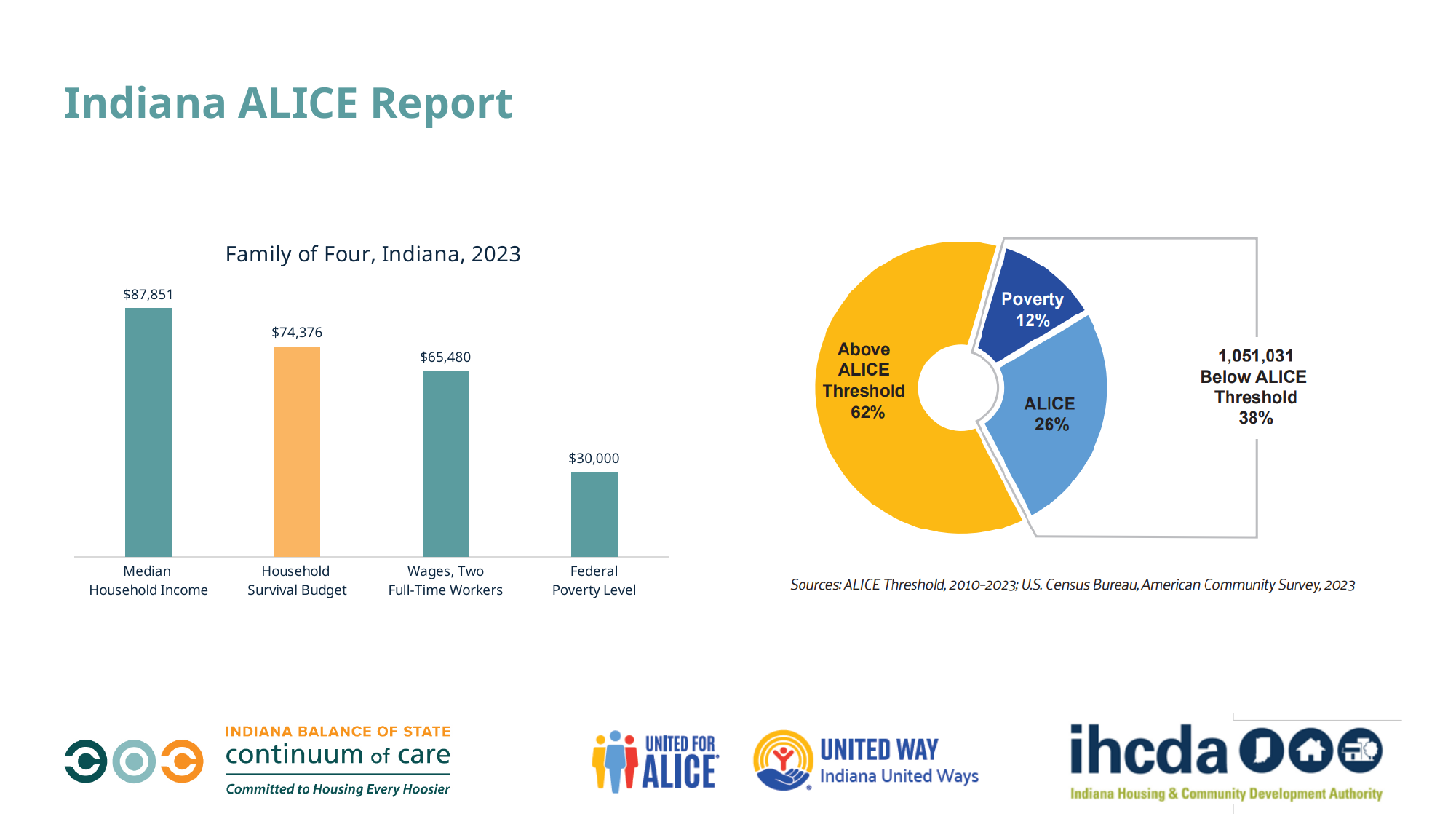
What kind of chart is the 'Family of Four, Indiana, 2023' chart on the left? Bar chart How many categories are shown in the 'Family of Four, Indiana, 2023' bar chart? 4 In the 'Family of Four, Indiana, 2023' bar chart, which category has the highest value? Median Household Income In the 'Family of Four, Indiana, 2023' bar chart, what is the value for Household Survival Budget? $74,376 In the 'Family of Four, Indiana, 2023' bar chart, what is the value for Median Household Income? $87,851 In the pie chart on the right, what share is labelled ALICE? 26% In the 'Family of Four, Indiana, 2023' bar chart, which category has the lowest value? Federal Poverty Level In the 'Family of Four, Indiana, 2023' bar chart, what is the value for Federal Poverty Level? $30,000 In the pie chart on the right, what share is labelled Poverty? 12% In the 'Family of Four, Indiana, 2023' bar chart, which is larger: Household Survival Budget or Wages, Two Full-Time Workers? Household Survival Budget In the pie chart on the right, which slice is the largest? Above ALICE Threshold In the 'Family of Four, Indiana, 2023' bar chart, what is the difference between Household Survival Budget and Wages, Two Full-Time Workers? $8,896